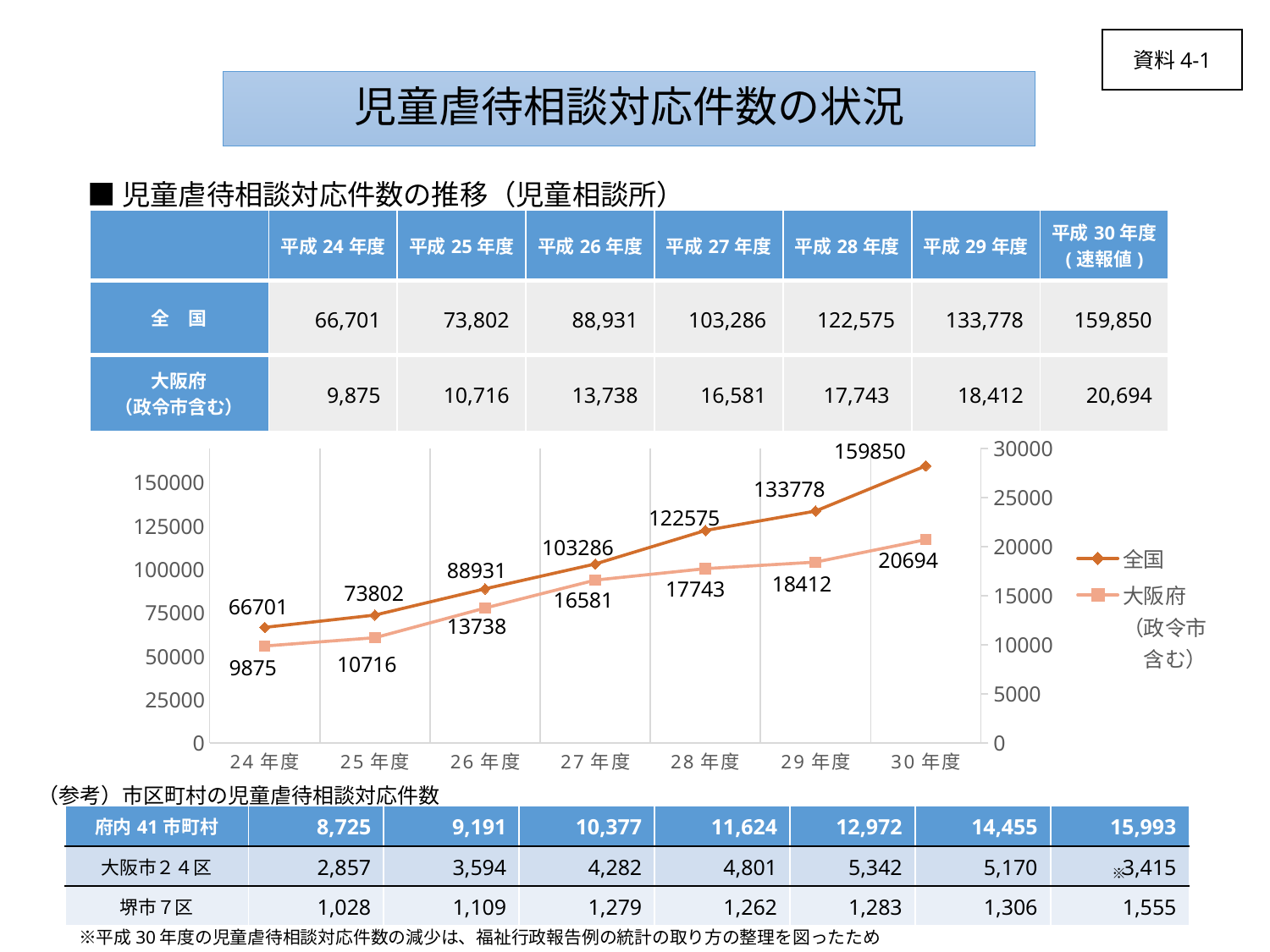
What is the data label for 全国 at 27年度 in the chart? 103286 What is the difference between the 全国 values for 30年度 and 29年度 in the chart? 26072 In which fiscal year is the 大阪府（政令市含む） value lowest in the chart? 24年度 Which is larger in the chart: the 全国 value for 25年度 or the 全国 value for 26年度? 26年度 Do the 全国 values rise or fall from 24年度 to 30年度 in the chart? rise What is the difference between the 大阪府（政令市含む） values for 28年度 and 27年度 in the chart? 1162 How many series does the chart legend list? 2 What kind of chart is shown on the slide? line chart In which fiscal year is the 全国 value highest in the chart? 30年度 What is the data label for 全国 at 30年度 in the chart? 159850 What is the data label for 大阪府（政令市含む） at 26年度 in the chart? 13738 How many fiscal years are plotted along the x axis of the chart? 7